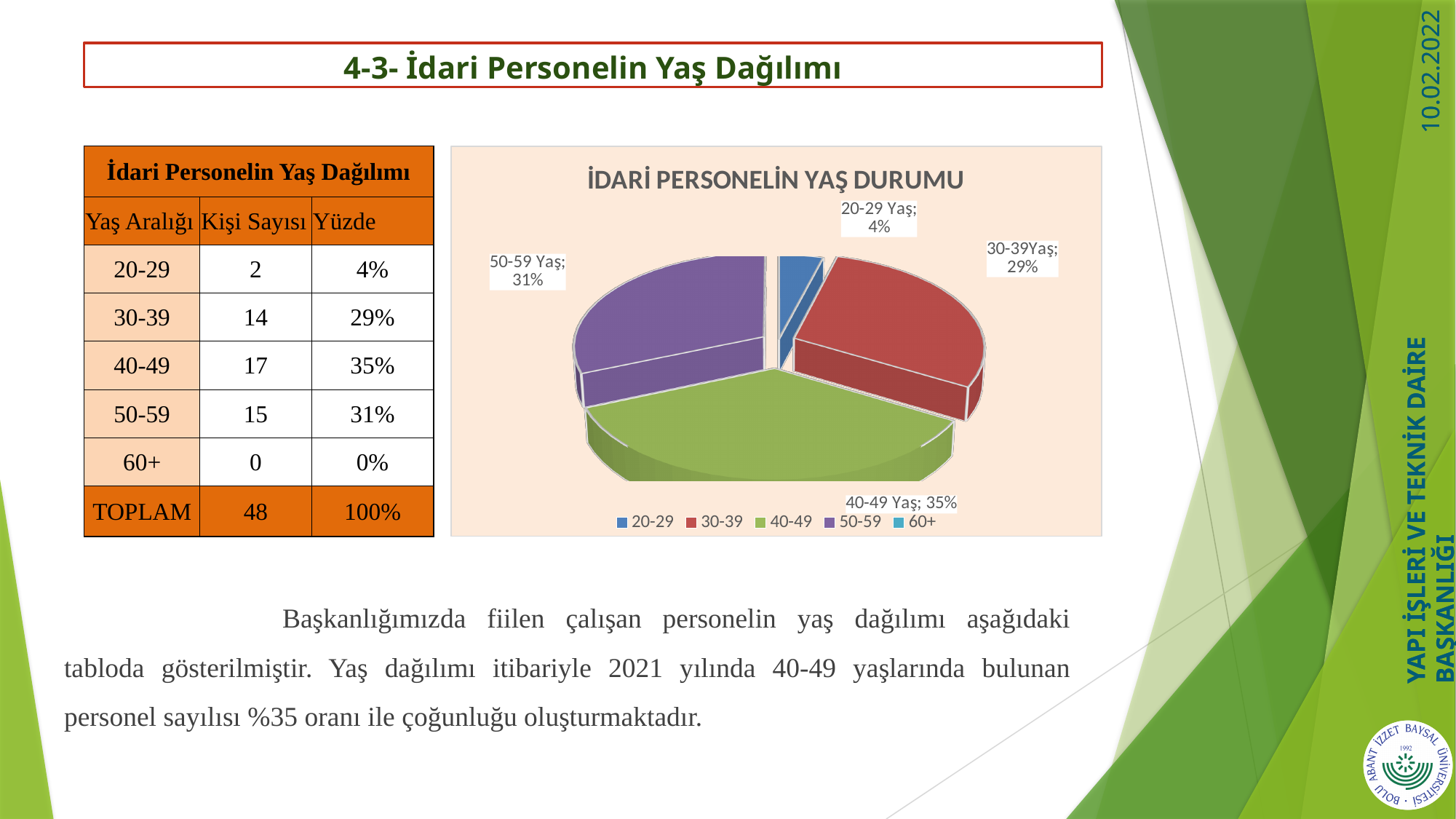
What percentage does the 40-49 Yaş slice show? 35% What type of chart is shown on the slide? pie chart Which slice is larger, 30-39 Yaş or 50-59 Yaş? 50-59 Yaş Which age group has the largest share of the pie? 40-49 How many entries does the chart legend list? 5 What percentage does the 50-59 Yaş slice show? 31% Which labelled slice has the smallest share of the pie? 20-29 What percentage does the 20-29 Yaş slice show? 4% What is the chart's title? İDARİ PERSONELİN YAŞ DURUMU What colour is the 40-49 slice in the pie chart? green What percentage does the 30-39 Yaş slice show? 29% What is the difference in percentage points between the 40-49 Yaş slice and the 20-29 Yaş slice? 31